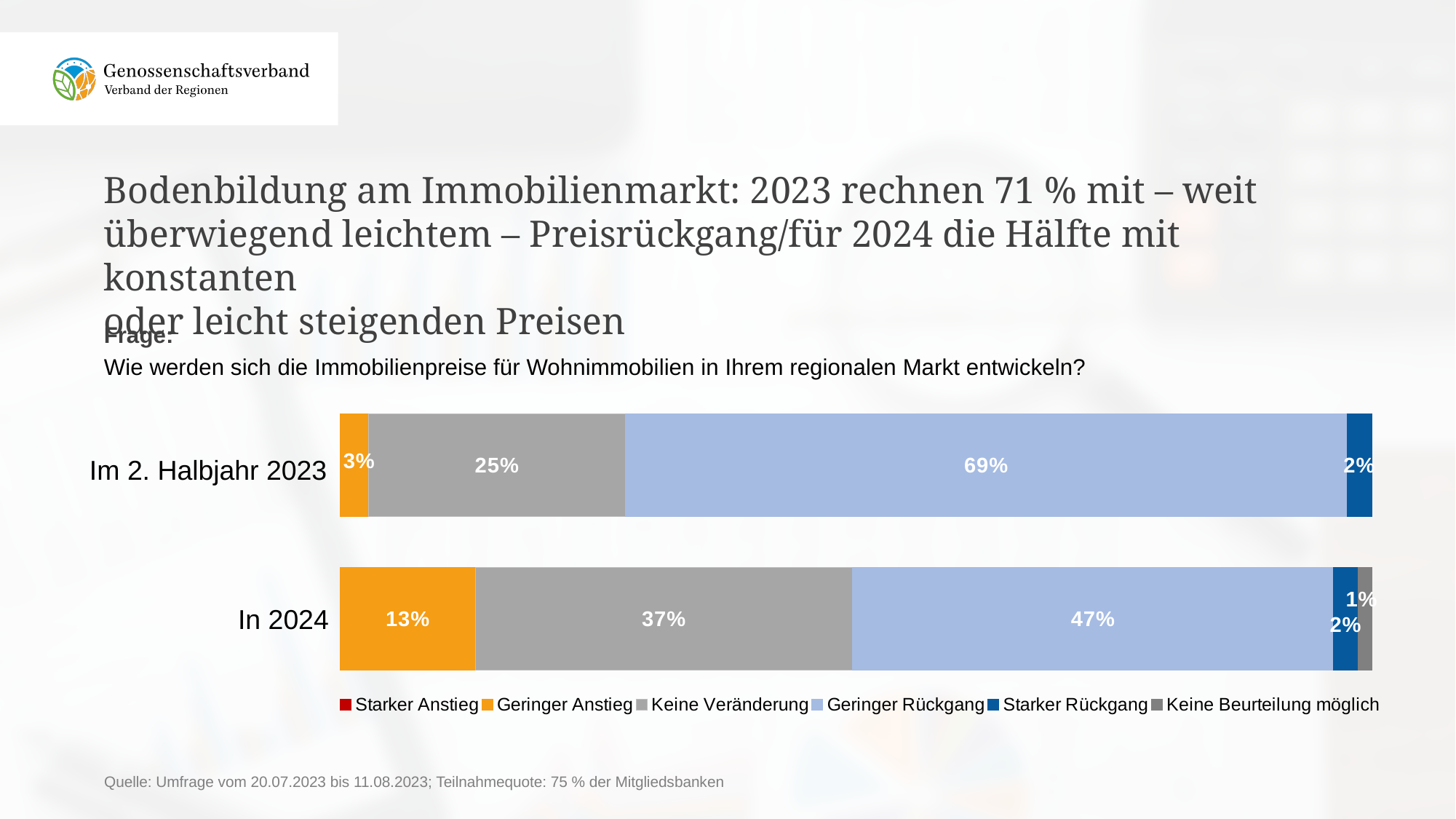
What is the difference between "Geringer Anstieg" in 2024 and "Geringer Anstieg" in the 2nd half of 2023? 10% Which legend entry is shown in orange? Geringer Anstieg What is the value for "Geringer Anstieg" in the "In 2024" bar? 13% What kind of chart is shown on the slide? stacked bar chart What is the difference between the "Geringer Rückgang" values for "Im 2. Halbjahr 2023" and "In 2024"? 22% Which segment is the largest in the "Im 2. Halbjahr 2023" bar? Geringer Rückgang What is the value for "Starker Rückgang" in the "Im 2. Halbjahr 2023" bar? 2% How many categories (bars) are plotted in the chart? 2 What is the value for "Keine Veränderung" in the "In 2024" bar? 37% How many series does the legend list? 6 Which is larger: "Keine Veränderung" in 2024 or "Keine Veränderung" in the 2nd half of 2023? Keine Veränderung in 2024 What is the value for "Geringer Rückgang" in the "Im 2. Halbjahr 2023" bar? 69%